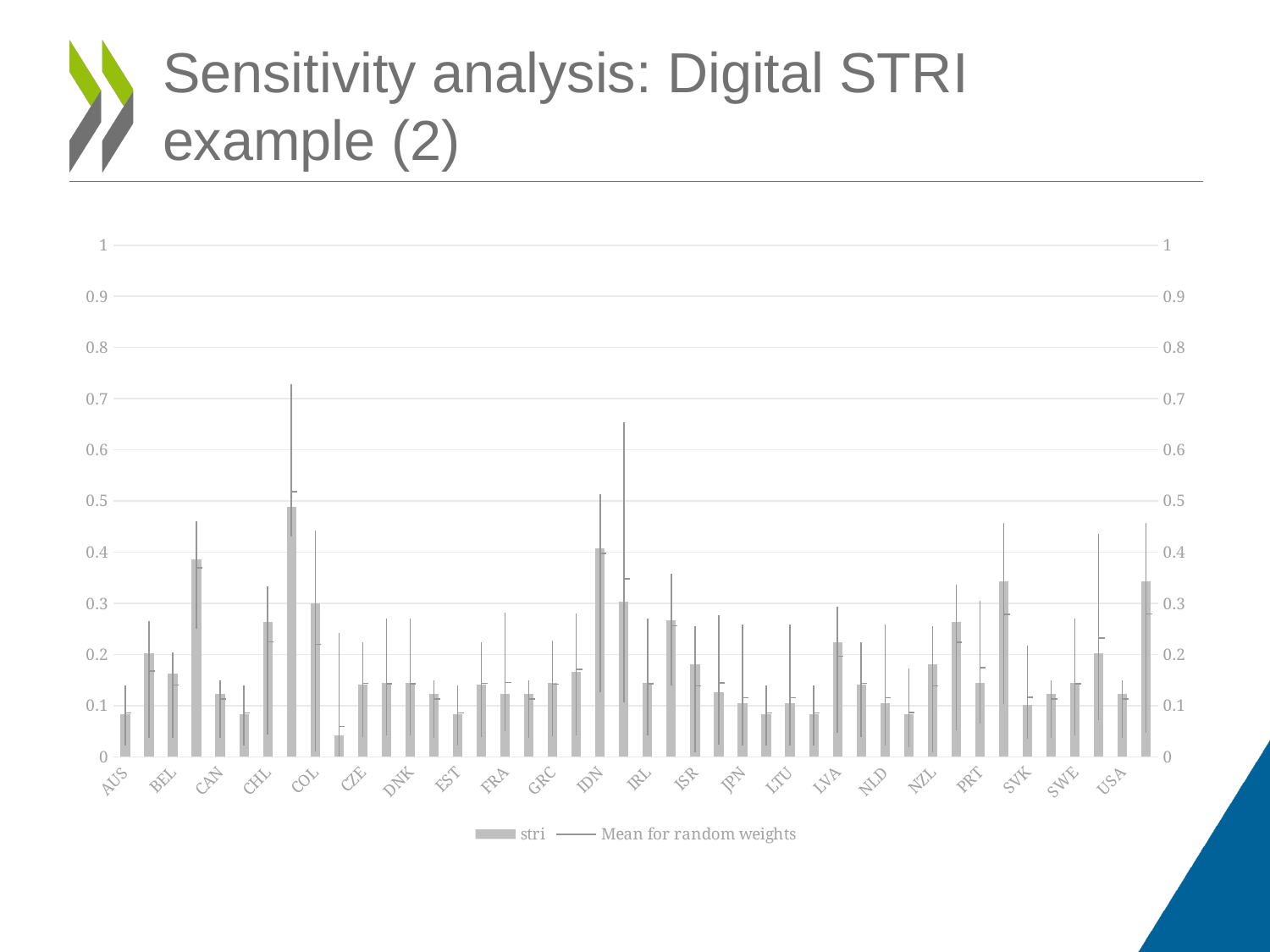
Is the stri value for EST greater or less than 0.1? less Is the stri value for DNK greater or less than 0.1? greater Is the stri value for AUS greater or less than 0.1? less Which has the larger stri value, IDN or CAN? IDN What is the maximum value shown on the vertical axis? 1 What kind of chart is shown on the slide? bar chart What are the two entries in the chart legend? stri; Mean for random weights How many series does the legend list? 2